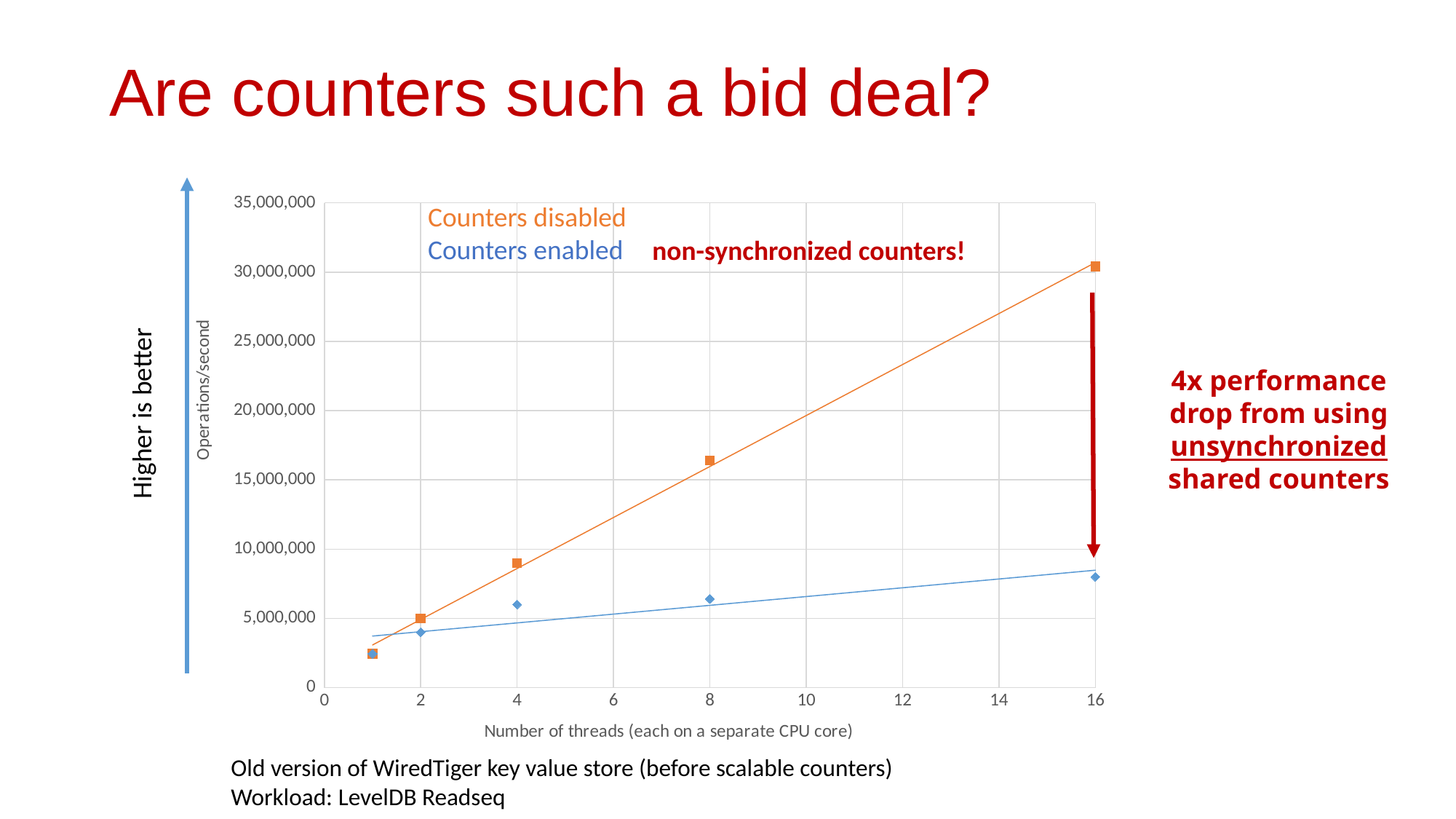
Is the value for Counters disabled at 8 threads greater or less than 15,000,000? greater Is the value for Counters disabled at 4 threads greater or less than 10,000,000? less What kind of chart is shown on the slide? Scatter chart What is the label of the y axis? Operations/second Does the Counters disabled series rise or fall as the number of threads increases? Rises Is the value for Counters enabled at 16 threads greater or less than 10,000,000? less How many data points are plotted for the Counters disabled series? 5 At 16 threads, which series has the higher operations/second: Counters disabled or Counters enabled? Counters disabled How many series does the chart's legend list? 2 What is the label of the x axis? Number of threads (each on a separate CPU core)